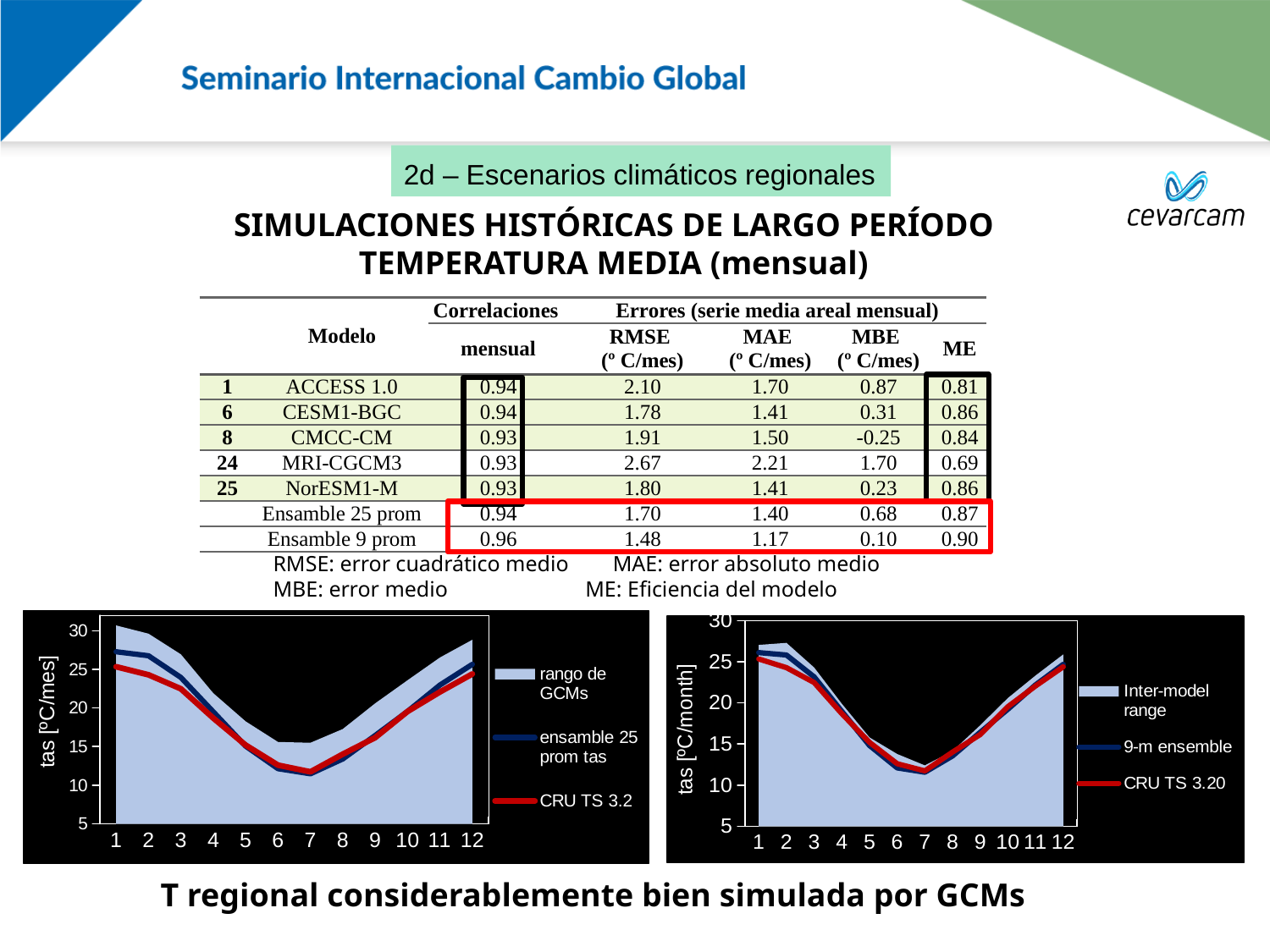
In the right chart, what is the name of the series drawn in red? CRU TS 3.20 In the right chart, do the 9-m ensemble values rise or fall from month 7 to month 12? rise In the left chart, what is the label on the y axis? tas [ºC/mes] In the left chart, do the CRU TS 3.2 values rise or fall from month 1 to month 7? fall In the right chart, how many series does the legend list? 3 In the right chart, is the value of CRU TS 3.20 at month 7 greater or less than 15? less In the right chart, how many points are plotted along the x axis? 12 In the left chart, how many series does the legend list? 3 In the left chart, is the value of CRU TS 3.2 at month 7 greater or less than 15? less In the left chart, is the value of ensamble 25 prom tas at month 1 greater or less than 25? greater In the left chart, how many months are shown along the x axis? 12